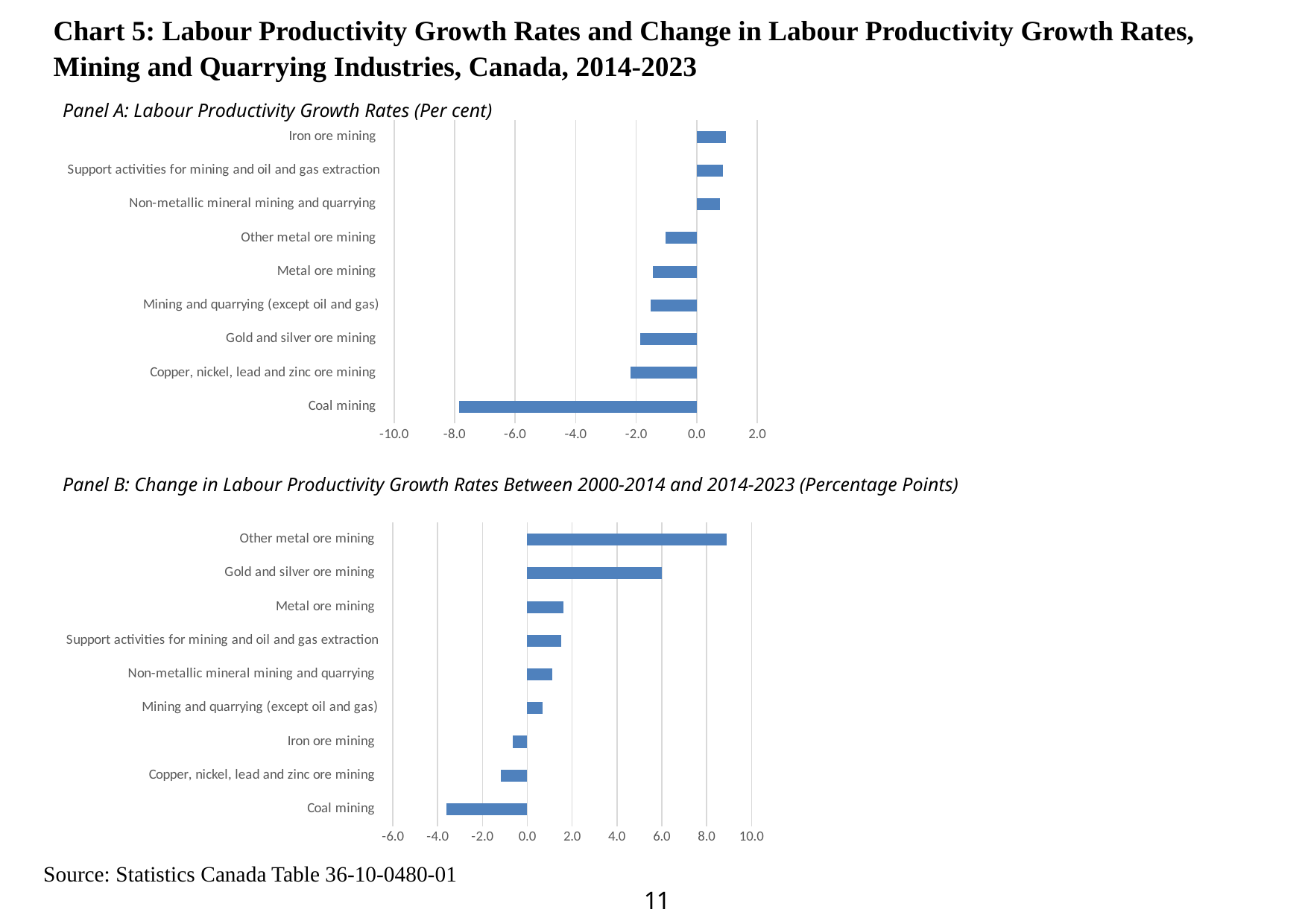
In Panel B: Change in Labour Productivity Growth Rates, which industry has the highest value? Other metal ore mining In Panel B: Change in Labour Productivity Growth Rates, which industry has the lowest value? Coal mining In Panel A: Labour Productivity Growth Rates, which industry has the lowest value? Coal mining In Panel A: Labour Productivity Growth Rates, is the value for Iron ore mining greater or less than 0.0? greater In Panel B: Change in Labour Productivity Growth Rates, is the value for Other metal ore mining greater or less than 8.0? greater In Panel B: Change in Labour Productivity Growth Rates, is the value for Coal mining greater or less than -2.0? less What kind of chart is Panel A: Labour Productivity Growth Rates? Bar chart How many industries are plotted in Panel A: Labour Productivity Growth Rates? 9 In Panel B: Change in Labour Productivity Growth Rates, which is larger, the value for Other metal ore mining or the value for Gold and silver ore mining? Other metal ore mining What unit is used for the values in Panel B according to its title? Percentage Points In Panel A: Labour Productivity Growth Rates, which is larger, the value for Coal mining or the value for Copper, nickel, lead and zinc ore mining? Copper, nickel, lead and zinc ore mining